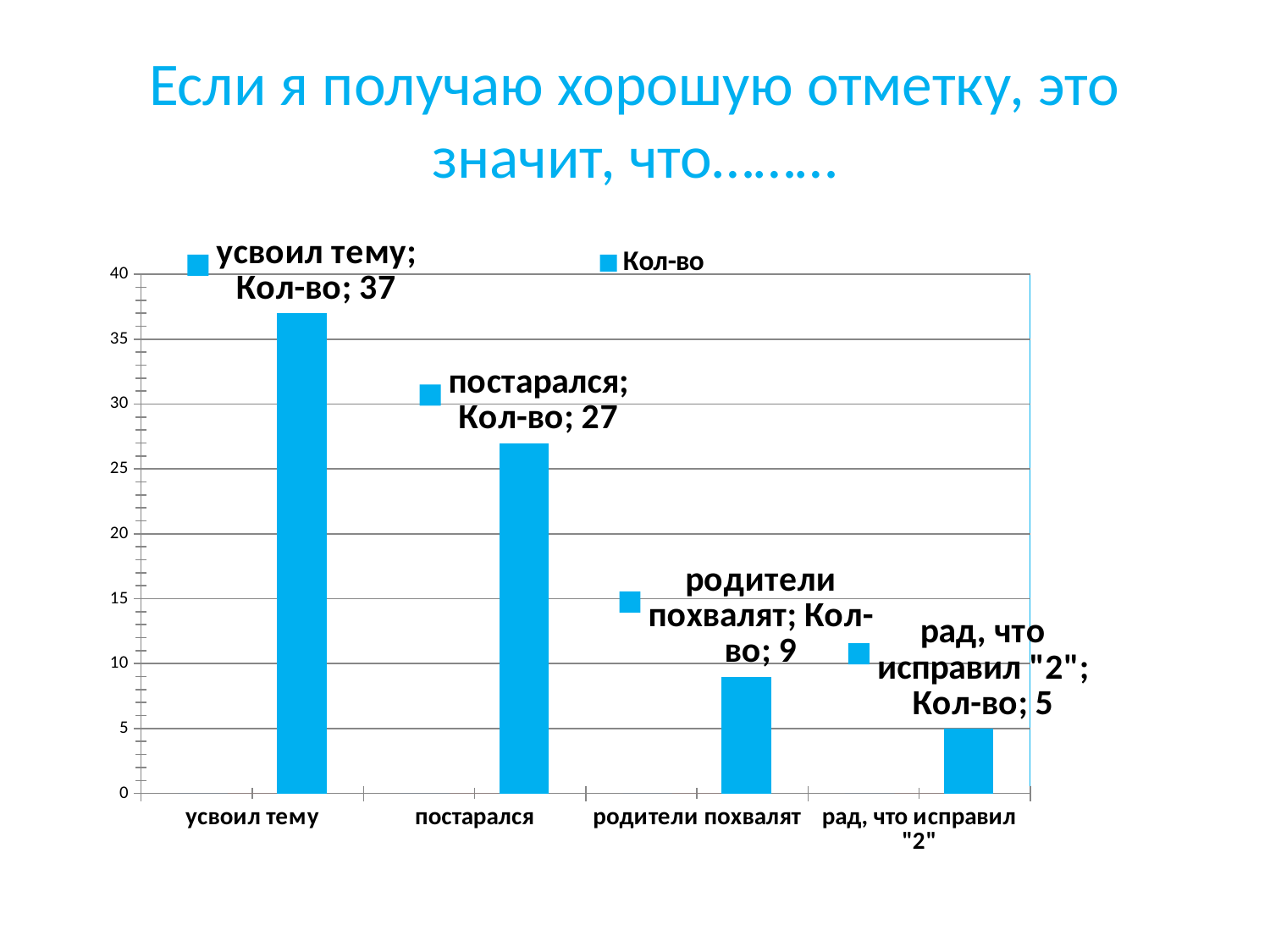
What is the value for "постарался"? 27 What is the value for "родители похвалят"? 9 What is the value for "усвоил тему"? 37 How many series does the legend list? 1 What kind of chart is shown on the slide? bar chart Which category has the lowest value? рад, что исправил "2" How many categories are shown on the x axis? 4 Which category has the highest value? усвоил тему What is the value for "рад, что исправил "2""? 5 What is the name of the series shown in the legend? Кол-во Which is larger, the value for "родители похвалят" or the value for "рад, что исправил "2""? родители похвалят What is the difference between the values for "усвоил тему" and "постарался"? 10